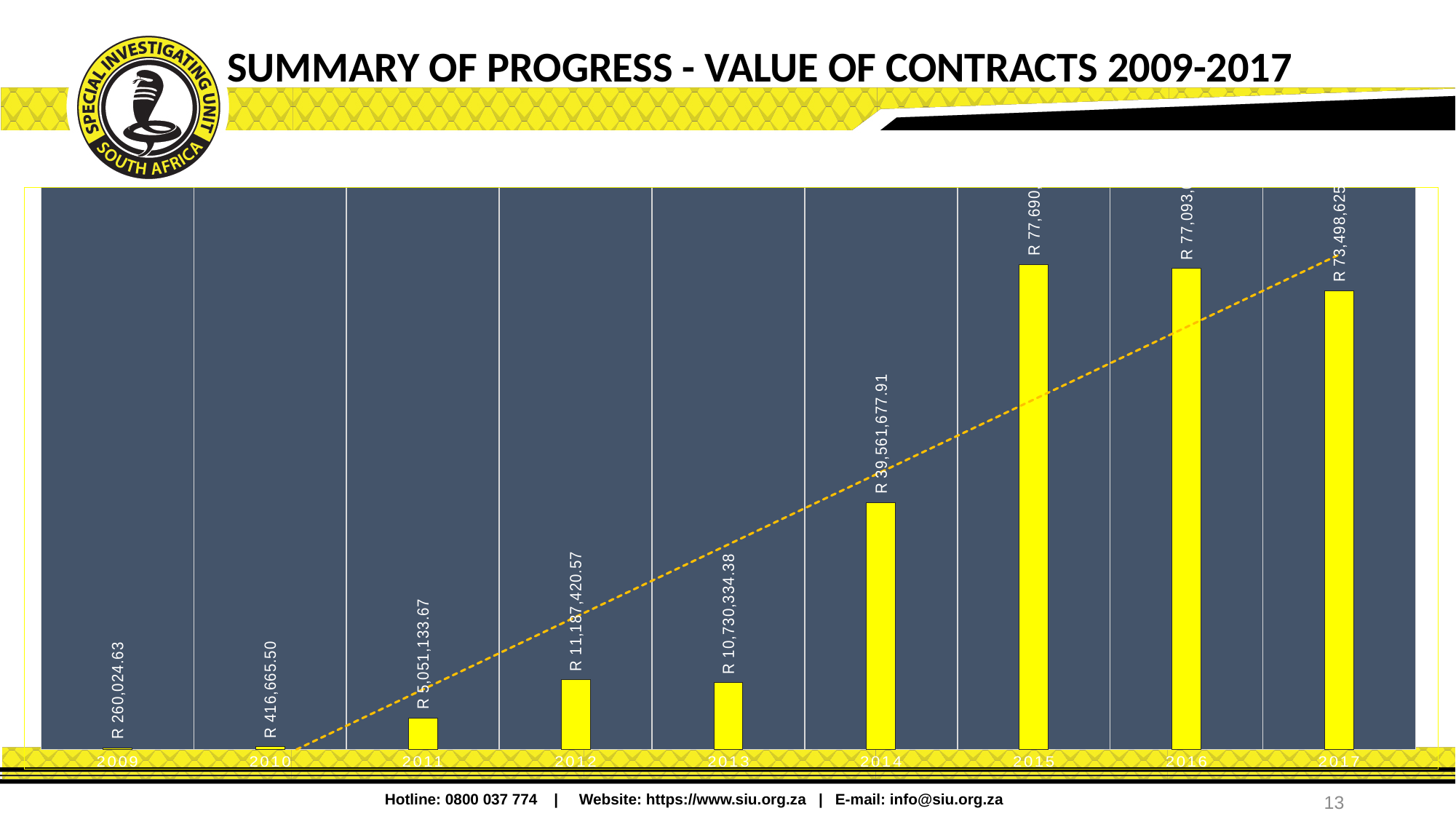
What is the value of contracts shown for 2011? R 5,051,133.67 What is the title of the slide containing the chart? SUMMARY OF PROGRESS - VALUE OF CONTRACTS 2009-2017 Which year has the larger value of contracts, 2012 or 2013? 2012 What is the value of contracts shown for 2009? R 260,024.63 What is the difference between the values for 2012 and 2013? R 457,086.19 What is the value of contracts shown for 2014? R 39,561,677.91 What is the value of contracts shown for 2010? R 416,665.50 What is the value of contracts shown for 2012? R 11,187,420.57 What is the value of contracts shown for 2013? R 10,730,334.38 How many years are shown on the x axis of the chart? 9 What kind of chart is shown on the slide? Bar chart Which year has the lowest value of contracts? 2009